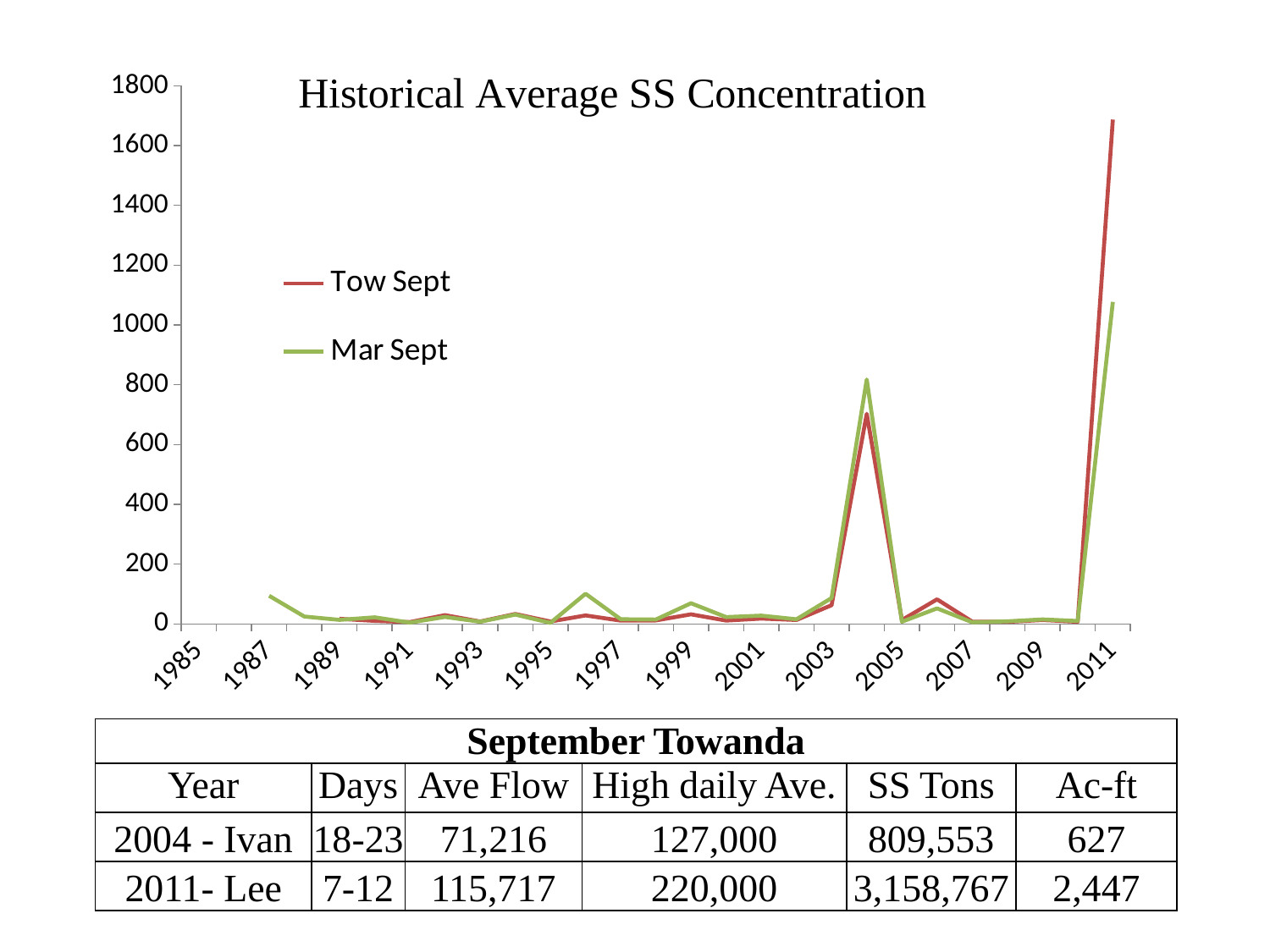
Is the Tow Sept value for 2004 greater or less than 800? less Is the Mar Sept value for 2011 greater or less than 800? greater In which year does the Mar Sept series reach its highest value? 2011 Which series is drawn in green in the chart? Mar Sept In 2004, which series has the higher value, Tow Sept or Mar Sept? Mar Sept What is the title of the chart? Historical Average SS Concentration Is the Tow Sept value for 2011 greater or less than 1400? greater In which year does the Tow Sept series reach its highest value? 2011 In 2011, which series has the higher value, Tow Sept or Mar Sept? Tow Sept How many series does the chart legend list? 2 What kind of chart is shown on the slide? line chart Do the values of both series rise or fall between 2004 and 2005? fall